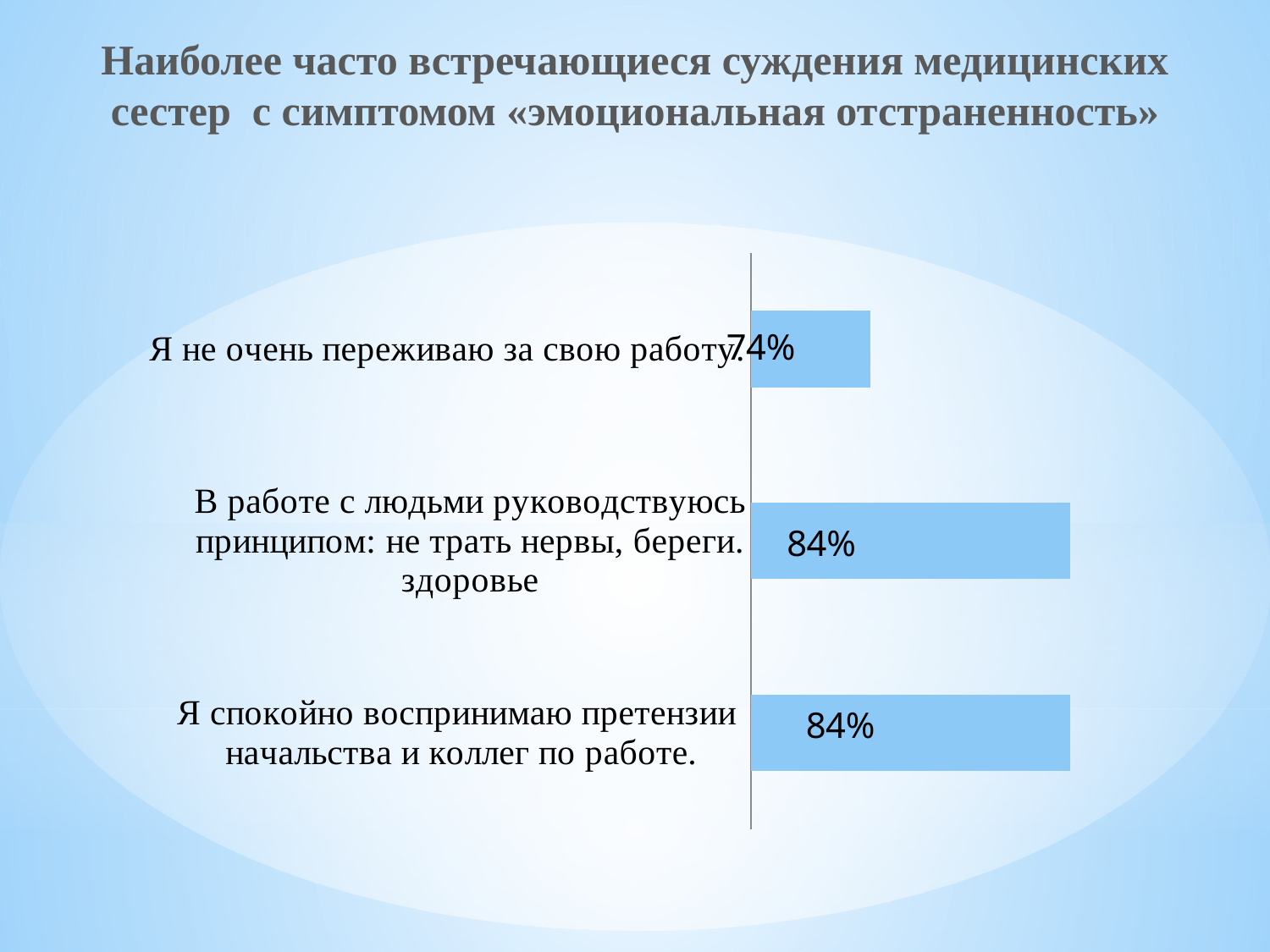
What is the title of the slide? Наиболее часто встречающиеся суждения медицинских сестер с симптомом «эмоциональная отстраненность» What value is shown for "В работе с людьми руководствуюсь принципом: не трать нервы, береги здоровье"? 84% What is the difference between the value for "Я спокойно воспринимаю претензии начальства и коллег по работе" and the value for "Я не очень переживаю за свою работу"? 10 percentage points How many statements (categories) are plotted in the chart? 3 What value is shown for "Я не очень переживаю за свою работу"? 74% What colour are the bars in the chart? Light blue What kind of chart is shown on the slide? Bar chart How many bars share the value 84%? 2 Which is larger: the value for "В работе с людьми руководствуюсь принципом: не трать нервы, береги здоровье" or the value for "Я не очень переживаю за свою работу"? В работе с людьми руководствуюсь принципом: не трать нервы, береги здоровье Which statement has the lowest value? Я не очень переживаю за свою работу What value is shown for "Я спокойно воспринимаю претензии начальства и коллег по работе"? 84%